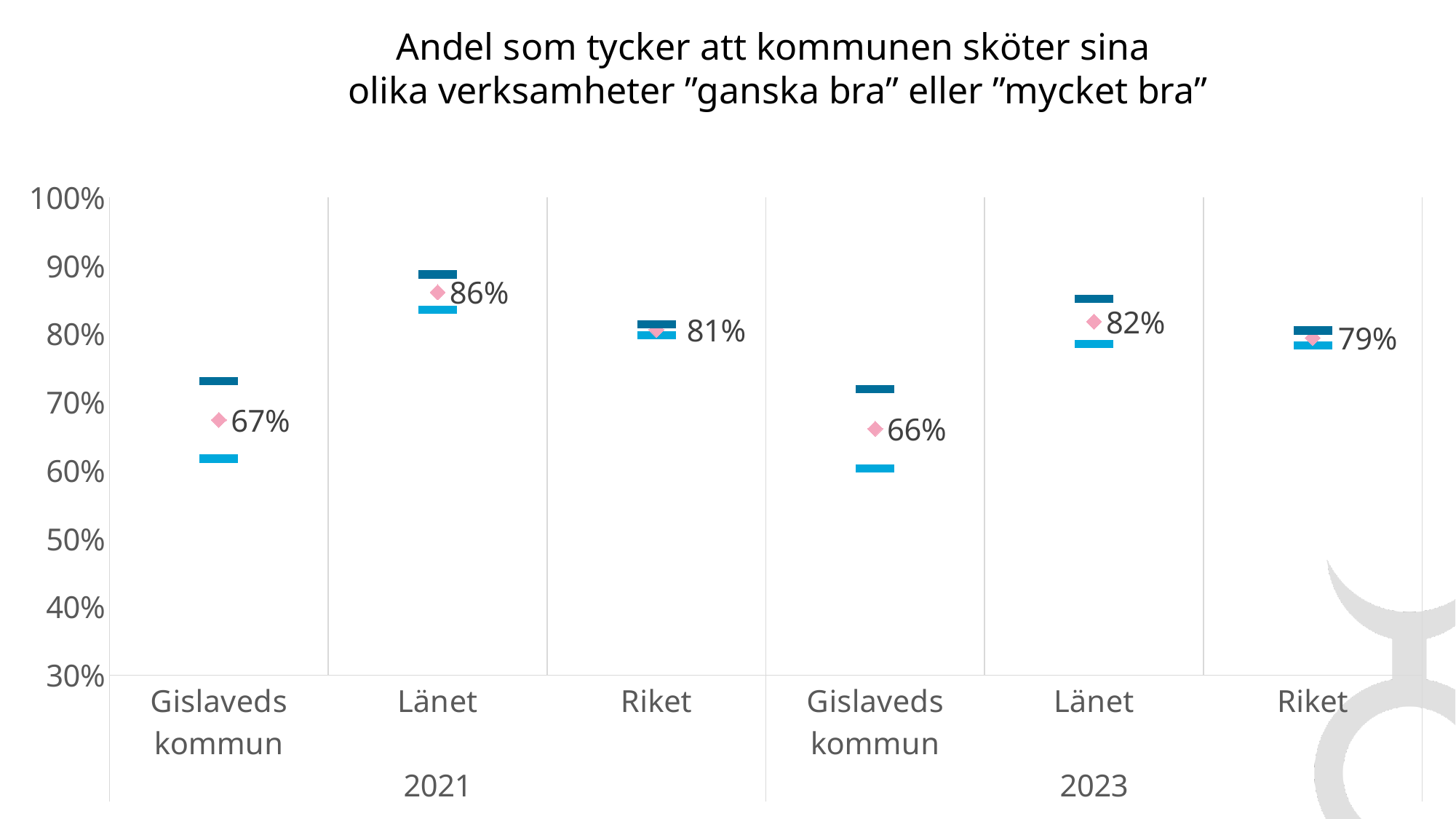
What is the difference between Länet in 2021 and Länet in 2023? 4 percentage points What is the value for Länet in 2021? 86% Which category and year has the highest value? Länet 2021 Did the value for Gislaveds kommun rise or fall from 2021 to 2023? fall What is the value for Gislaveds kommun in 2023? 66% What is the value for Gislaveds kommun in 2021? 67% Is the value for Gislaveds kommun in 2023 greater or less than 70%? less Which category and year has the lowest value? Gislaveds kommun 2023 Which is larger, Riket in 2021 or Riket in 2023? Riket in 2021 How many data points are plotted in the chart? 18 What is the difference between Länet and Gislaveds kommun in 2021? 19 percentage points What is the value for Riket in 2023? 79%